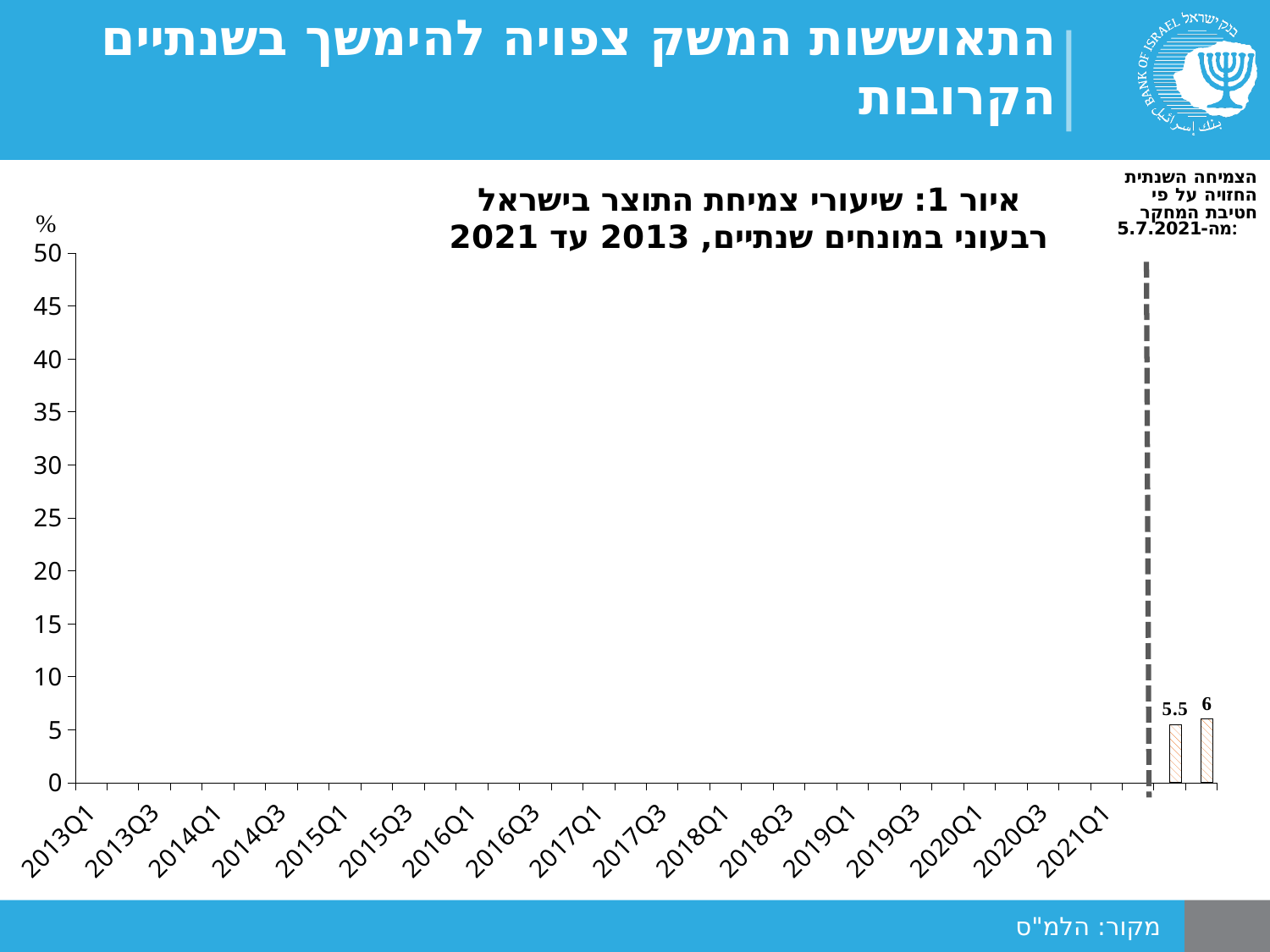
How many bars with printed data labels are visible on the chart? 2 What is the value printed on the first hatched bar to the right of the dashed vertical line? 5.5 Is the value of the bar labelled 5.5 greater or less than 10? less What is the maximum value shown on the vertical axis? 50 What is the first category label on the horizontal axis? 2013Q1 What is the value printed on the second (rightmost) hatched bar to the right of the dashed vertical line? 6 What is the difference between the two labelled hatched bars (6 and 5.5)? 0.5 Which of the two labelled hatched bars is larger, the left one or the right one? the right one (6) Is the value of the bar labelled 6 greater or less than 5? greater What is the highest value printed as a data label on the chart? 6 What is the last category label printed on the horizontal axis? 2021Q1 What kind of chart is shown on the slide? bar chart